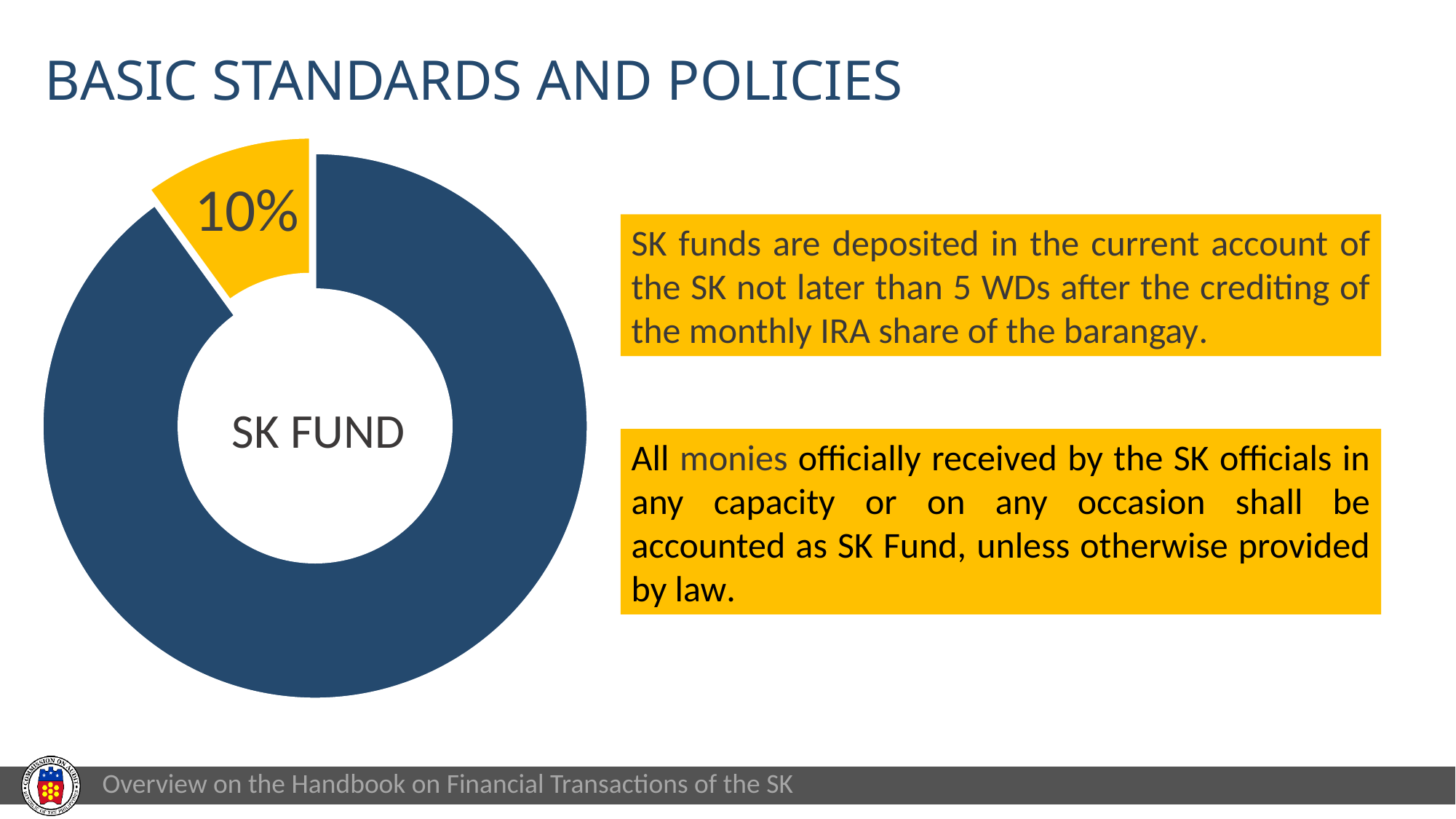
What colour is the slice labelled 10%? yellow Which slice of the doughnut chart is the smallest? the yellow slice (10%) What kind of chart is shown on the slide? doughnut chart What percentage is printed on the yellow slice of the doughnut chart? 10% What share of the doughnut does the yellow slice represent? 10% How many slices does the doughnut chart have? 2 What text is written in the centre of the doughnut chart? SK FUND Which slice of the doughnut chart is larger, the blue one or the yellow one? the blue one